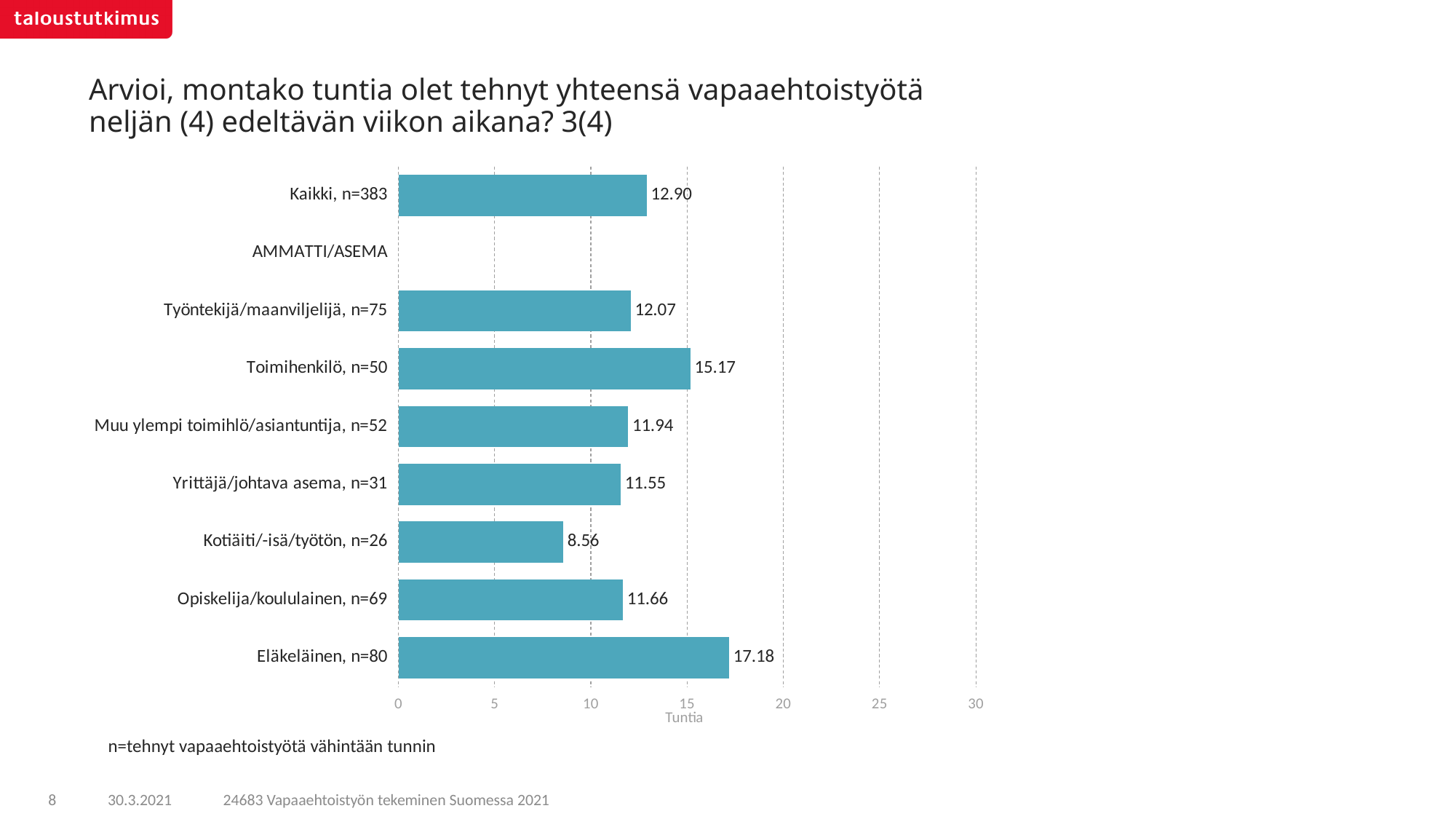
Which category has the highest value? Eläkeläinen, n=80 Which is larger, the value for Toimihenkilö, n=50 or the value for Työntekijä/maanviljelijä, n=75? Toimihenkilö, n=50 Is the value for Opiskelija/koululainen, n=69 greater or less than 10? greater What kind of chart is shown on the slide? bar chart How many bars are plotted in the chart? 8 What is the difference between the values for Eläkeläinen, n=80 and Kotiäiti/-isä/työtön, n=26? 8.62 What is the value for Eläkeläinen, n=80? 17.18 What is the label of the horizontal axis? Tuntia What is the value for Kaikki, n=383? 12.90 What is the value for Kotiäiti/-isä/työtön, n=26? 8.56 Which category has the lowest value? Kotiäiti/-isä/työtön, n=26 What is the value for Toimihenkilö, n=50? 15.17